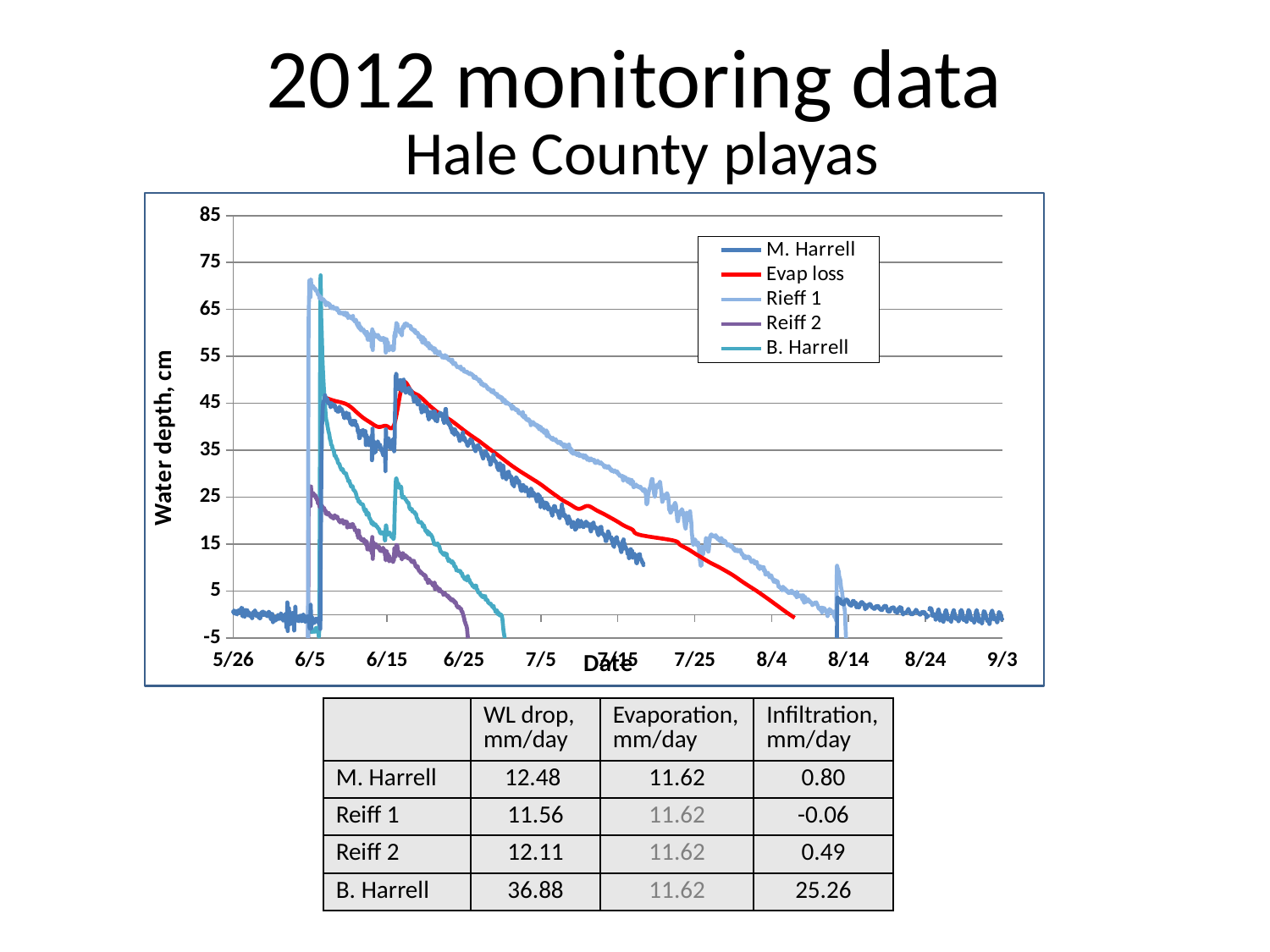
Which series in the chart is drawn in red? Evap loss Around 7/5, which series has the higher water depth, Rieff 1 or M. Harrell? Rieff 1 Around 6/20, which series has the higher water depth, Reiff 2 or B. Harrell? B. Harrell Is the peak value of the Rieff 1 series around 6/5 greater or less than 65? greater Is the peak value of the Reiff 2 series greater or less than 35? less How many series does the chart legend list? 5 What kind of chart is shown on the slide? line chart What is the title of the vertical axis of the chart? Water depth, cm Does the Evap loss series rise or fall between 6/17 and 8/7? fall Is the value of the M. Harrell series around 7/15 greater or less than 25? less Does the Rieff 1 series rise or fall between 6/7 and 8/14? fall